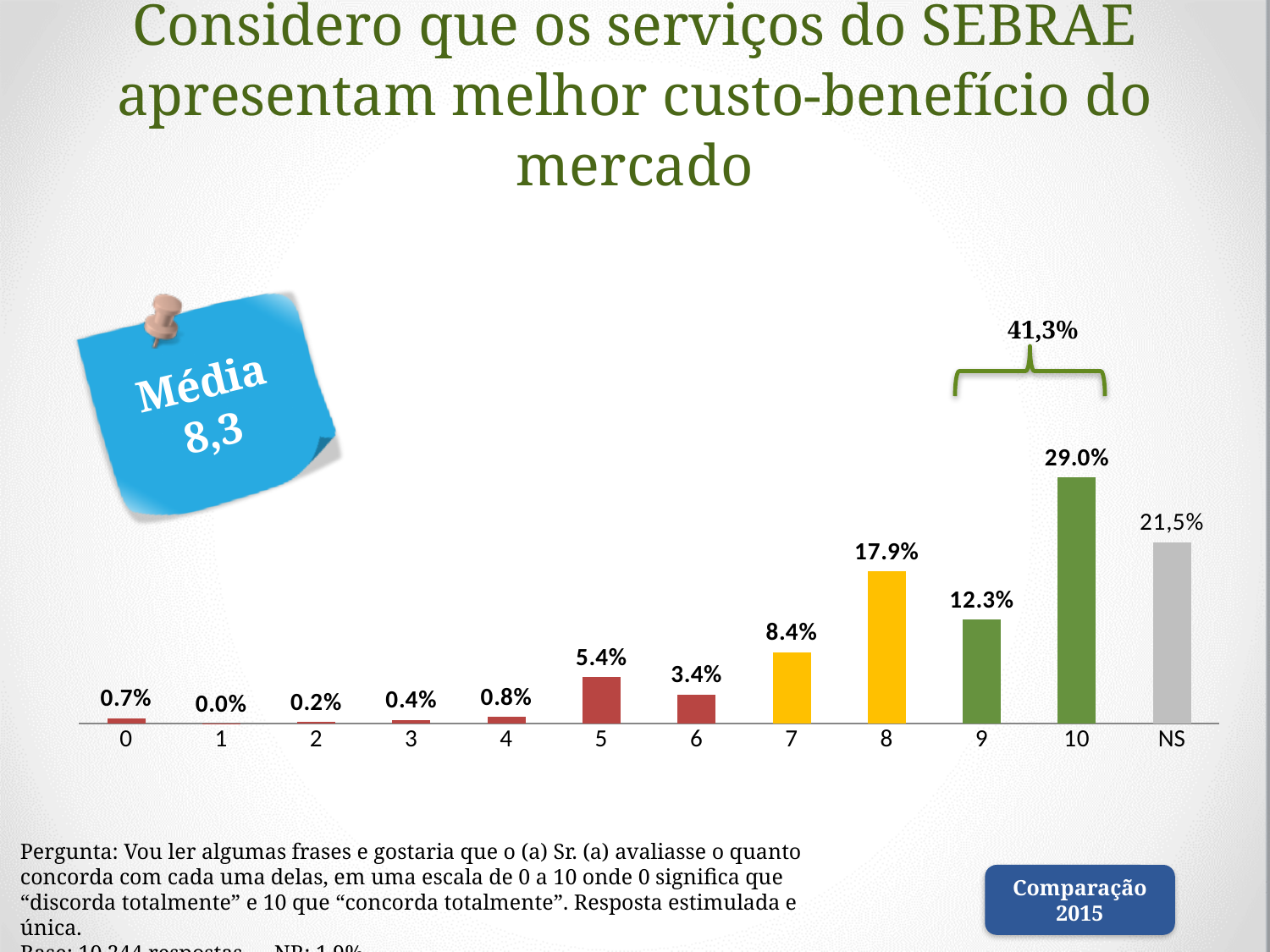
What is the value shown for the NS category? 21,5% What average (Média) is shown on the blue note? 8,3 How many categories are shown on the x axis? 12 What percentage of respondents gave a score of 10? 29.0% What percentage of respondents gave a score of 5? 5.4% What is the difference between the percentages for scores 10 and 9? 16.7% What combined percentage is shown by the bracket above scores 9 and 10? 41,3% Which score category has the highest percentage? 10 What kind of chart is shown on the slide? bar chart What percentage of respondents gave a score of 8? 17.9% Which score category has the lowest percentage? 1 Which is larger, the percentage for score 8 or for score 9? 8